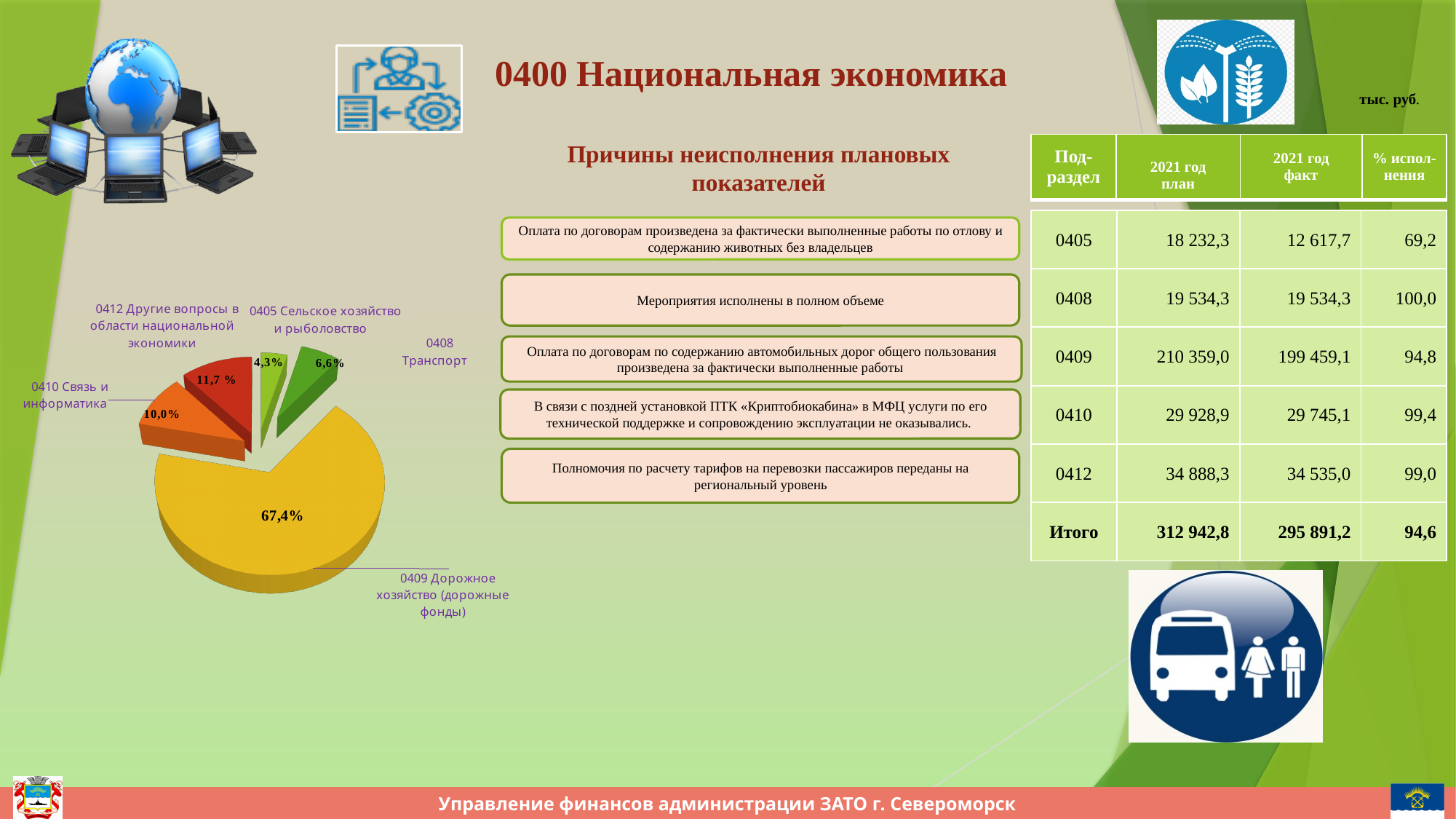
What is the value shown for 0408 Транспорт in the pie chart? 6,6% What is the value shown for 0410 Связь и информатика in the pie chart? 10,0% What kind of chart is shown on the slide? pie chart What is the difference in percentage points between 0412 Другие вопросы в области национальной экономики and 0405 Сельское хозяйство и рыболовство in the pie chart? 7,4 Which is larger in the pie chart: 0410 Связь и информатика or 0408 Транспорт? 0410 Связь и информатика Which slice of the pie chart is the smallest? 0405 Сельское хозяйство и рыболовство How many slices does the pie chart have? 5 What share of the pie does 0409 Дорожное хозяйство (дорожные фонды) have? 67,4% What is the value shown for 0412 Другие вопросы в области национальной экономики in the pie chart? 11,7 % What is the value shown for 0405 Сельское хозяйство и рыболовство in the pie chart? 4,3% Which slice of the pie chart is the largest? 0409 Дорожное хозяйство (дорожные фонды) What colour is the largest slice of the pie chart? yellow